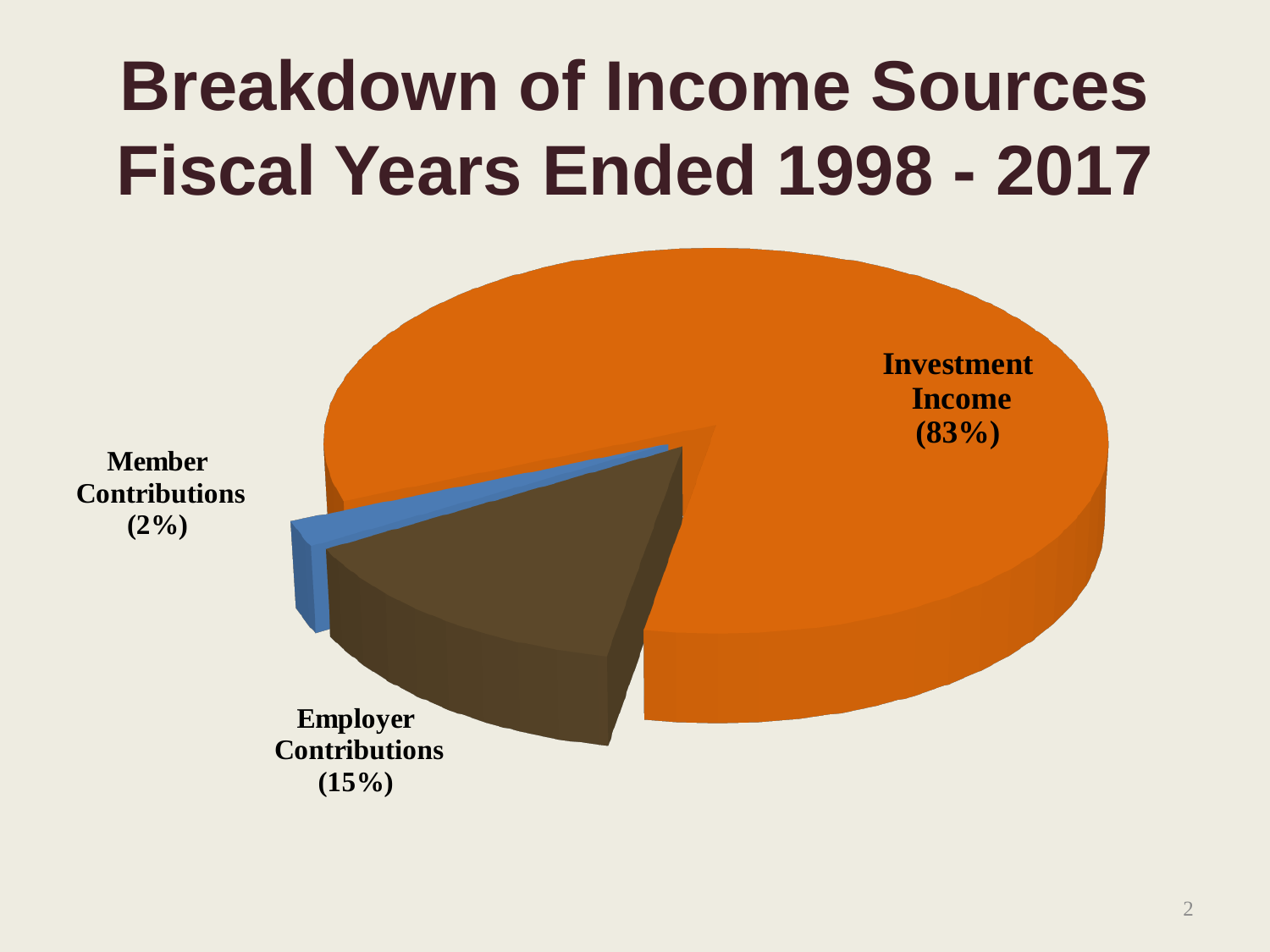
Which income source has the smallest share? Member Contributions What share of income does Employer Contributions represent? 15% What kind of chart is shown on the slide? Pie chart Which income source has the largest share? Investment Income What share of income does Investment Income represent? 83% What share of income does Member Contributions represent? 2% How many income sources are shown in the pie chart? 3 What is the difference in percentage points between Investment Income and Employer Contributions? 68 Which is larger, Employer Contributions or Member Contributions? Employer Contributions What colour is the Investment Income slice? Orange What is the title of the chart? Breakdown of Income Sources Fiscal Years Ended 1998 - 2017 What is the difference in percentage points between Employer Contributions and Member Contributions? 13